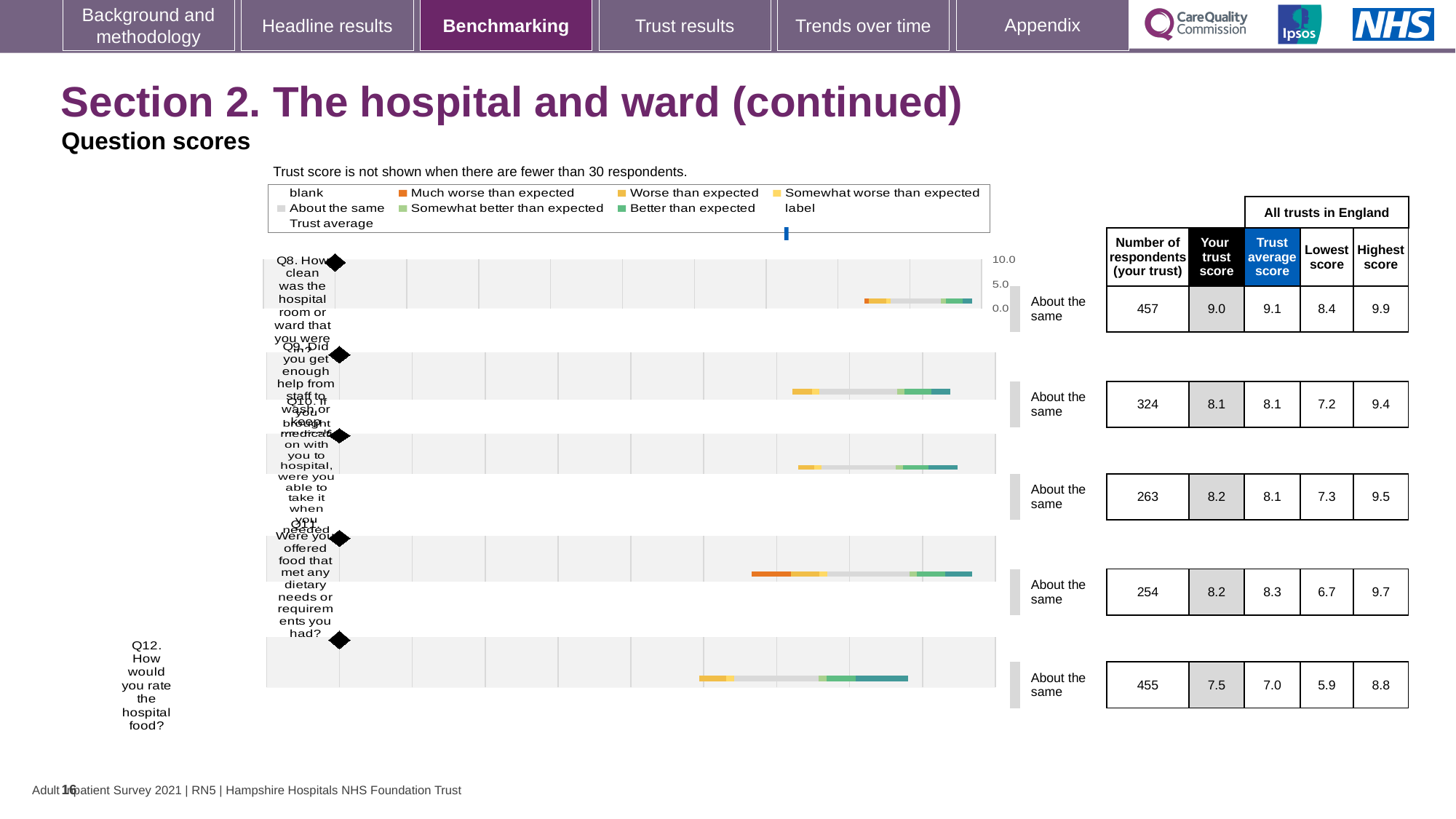
What is the number of respondents (your trust) for Q8? 457 For Q11, which is larger: the 'Your trust score' or the 'Trust average score'? Trust average score Which question has the lowest 'Your trust score'? Q12 What is the 'Your trust score' for Q12 (How would you rate the hospital food?)? 7.5 What kind of chart is used to show the question scores for Q8 to Q12? bar chart What is the highest score across all trusts in England for Q11? 9.7 What benchmark category is shown for Q9 (Did you get enough help from staff to wash or keep yourself clean)? About the same For Q12, what is the difference between the highest score and the lowest score across all trusts in England? 2.9 Which question has the highest 'Your trust score'? Q8 How many questions (Q8 to Q12) are plotted on the chart? 5 What is the lowest score across all trusts in England for Q10? 7.3